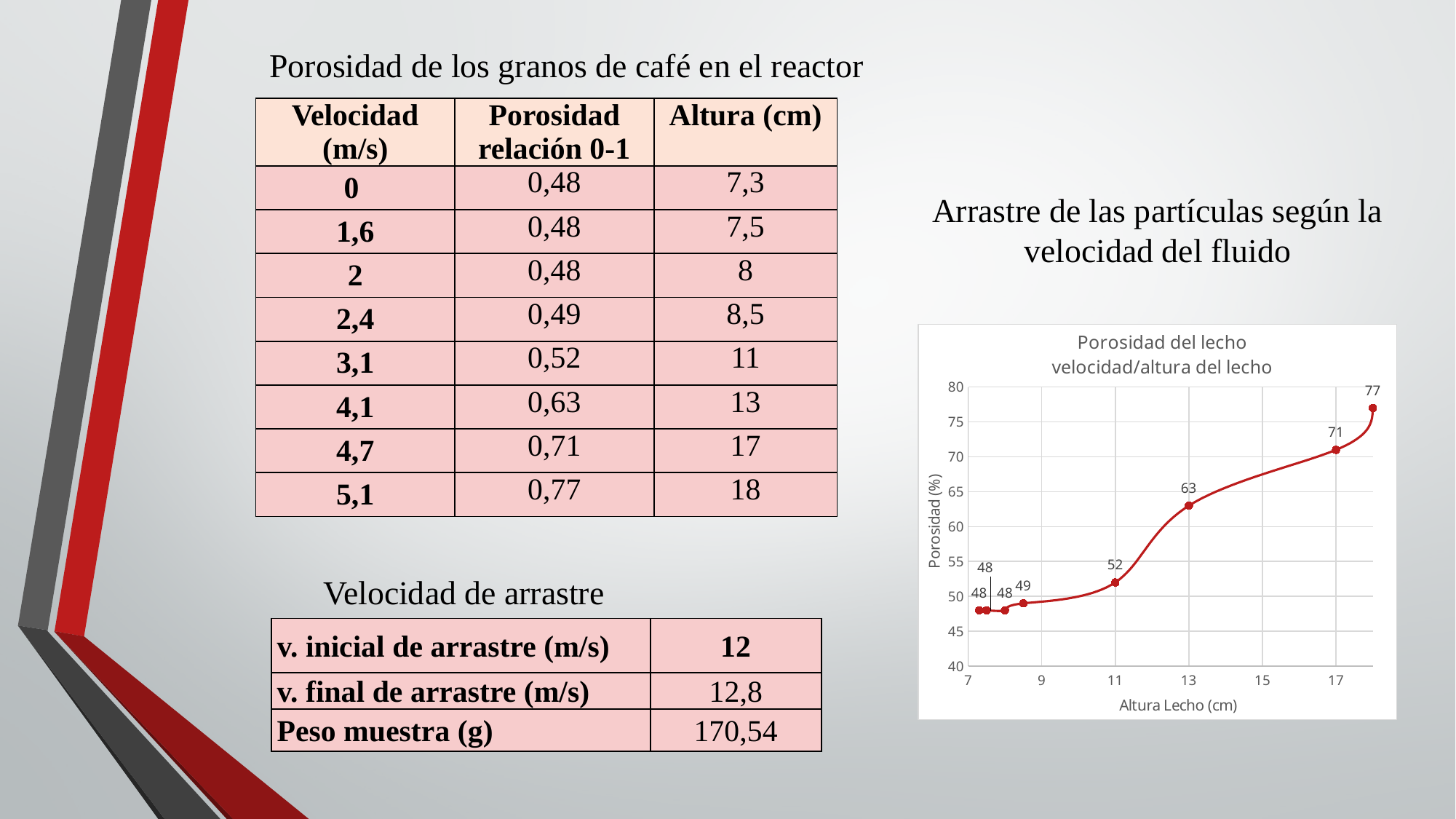
What is the porosity value at a bed height (Altura Lecho) of 17 cm? 71 What kind of chart is shown on the slide? line chart What is the lowest porosity value labelled on the chart? 48 Is the porosity value at a bed height of 13 cm greater or less than 60? greater Do the porosity values rise or fall as bed height increases along the x axis? rise What is the porosity value at a bed height (Altura Lecho) of 13 cm? 63 What is the porosity value at a bed height (Altura Lecho) of 11 cm? 52 What is the title of the x axis of the chart? Altura Lecho (cm) Which is larger: the porosity at 13 cm or the porosity at 11 cm? 13 cm What is the highest porosity value labelled on the chart? 77 How many data points are plotted on the chart? 8 What is the difference between the porosity at the rightmost point (77) and the porosity at 17 cm (71)? 6